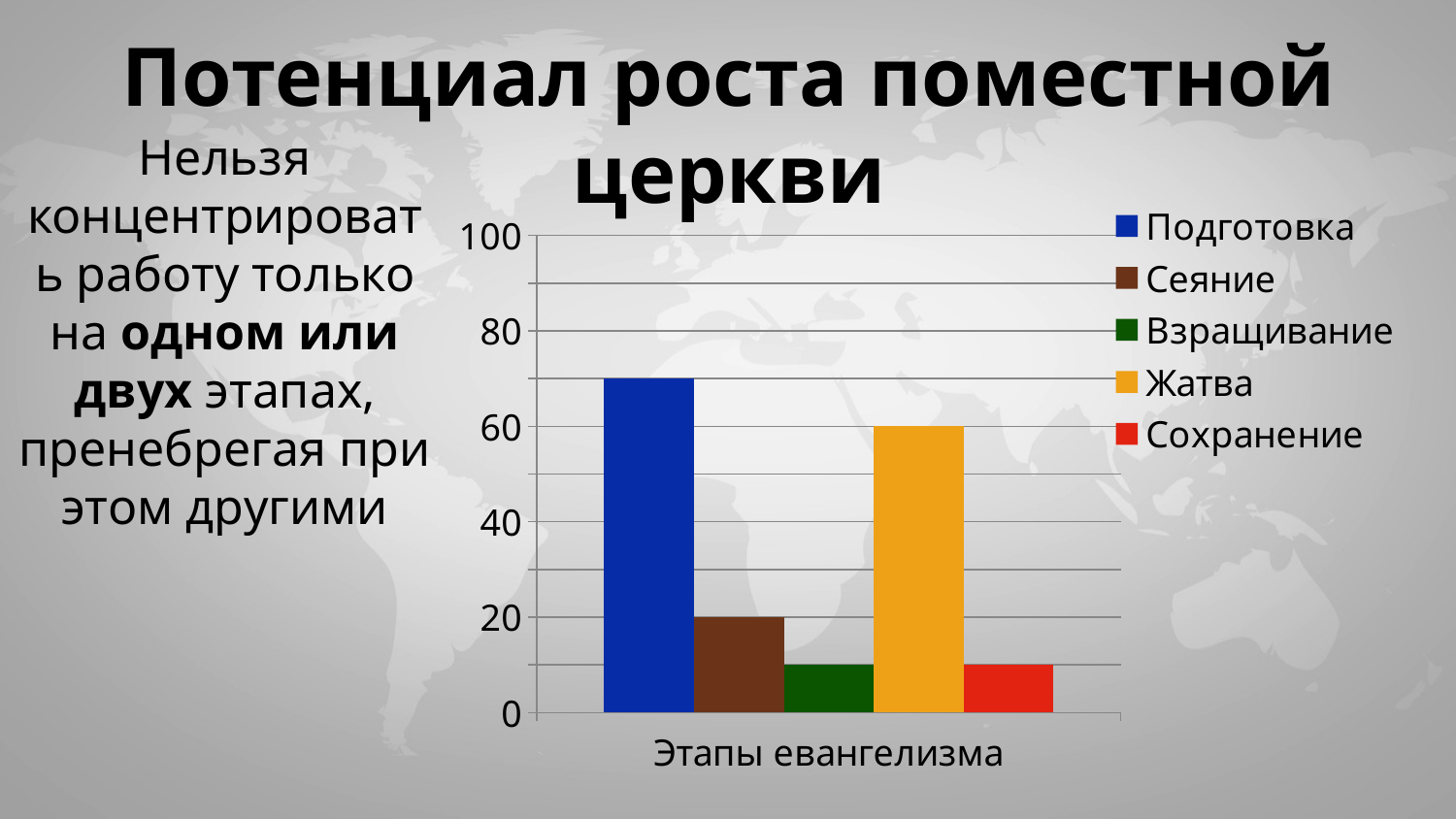
What is the value for Сеяние? 20 How many series does the legend list? 5 What kind of chart is shown on the slide? bar chart Is the value for Сохранение greater or less than 20? less How many categories are shown on the x axis? 1 Is the value for Подготовка greater or less than 60? greater What is the difference between the values for Жатва and Сеяние? 40 Is the value for Взращивание greater or less than 20? less What is the value for Жатва? 60 Which series has the highest bar? Подготовка What is the label on the x axis of the chart? Этапы евангелизма Which is larger, the value for Жатва or the value for Сеяние? Жатва